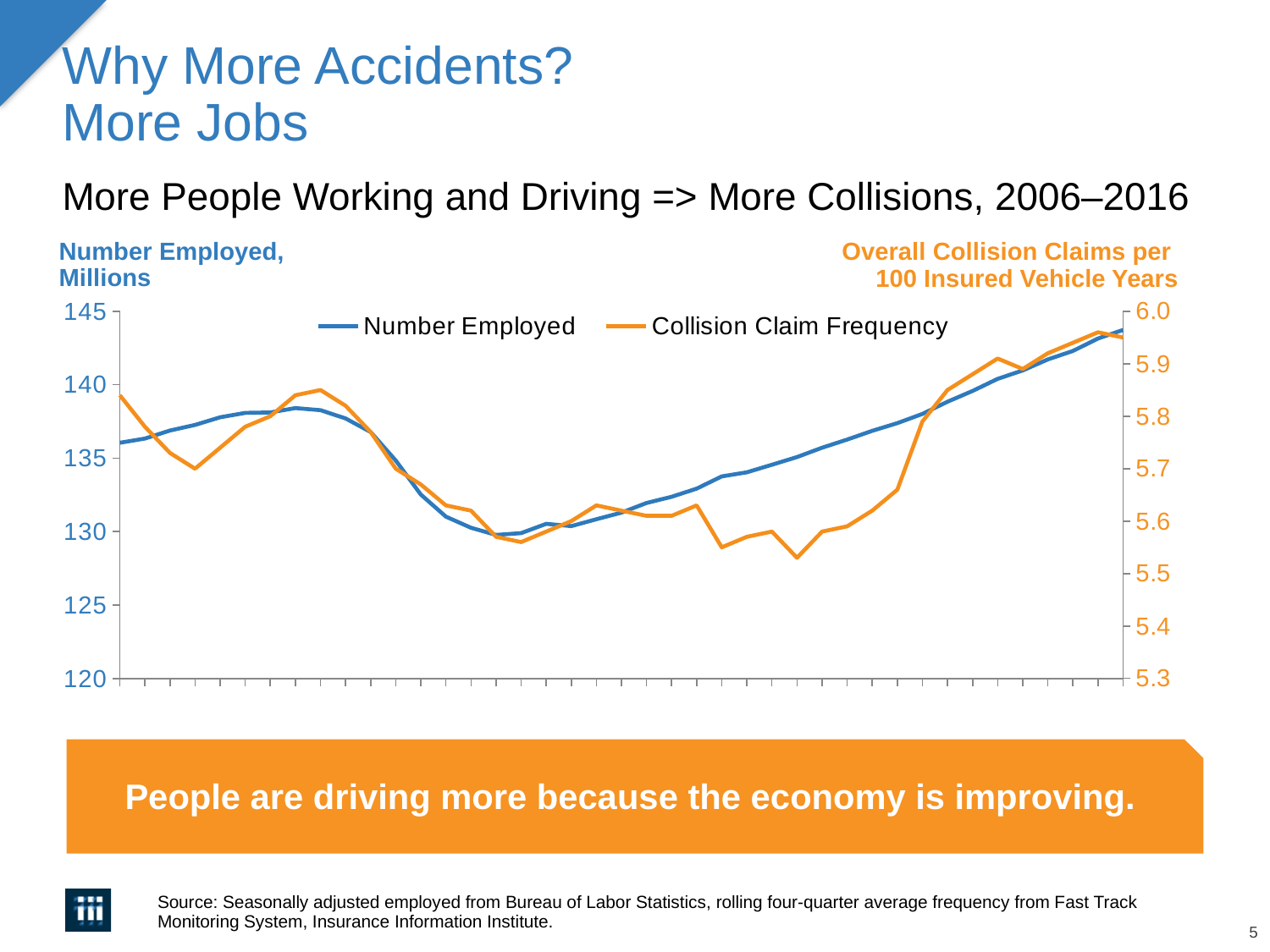
Is the lowest value of the Number Employed line greater or less than 135? less Is the highest value of the Number Employed line greater or less than 140? greater Is the highest value of the Collision Claim Frequency line greater or less than 5.9? greater What is the maximum value shown on the left vertical axis of the chart? 145 In the right-hand third of the chart, does the Collision Claim Frequency line rise or fall? rise Over the whole period shown, does the Number Employed line end higher or lower than it starts? higher How many series does the chart's legend list? 2 What are the two series named in the chart's legend? Number Employed and Collision Claim Frequency What kind of chart is shown on the slide? Line chart What is the title of the left vertical axis of the chart? Number Employed, Millions